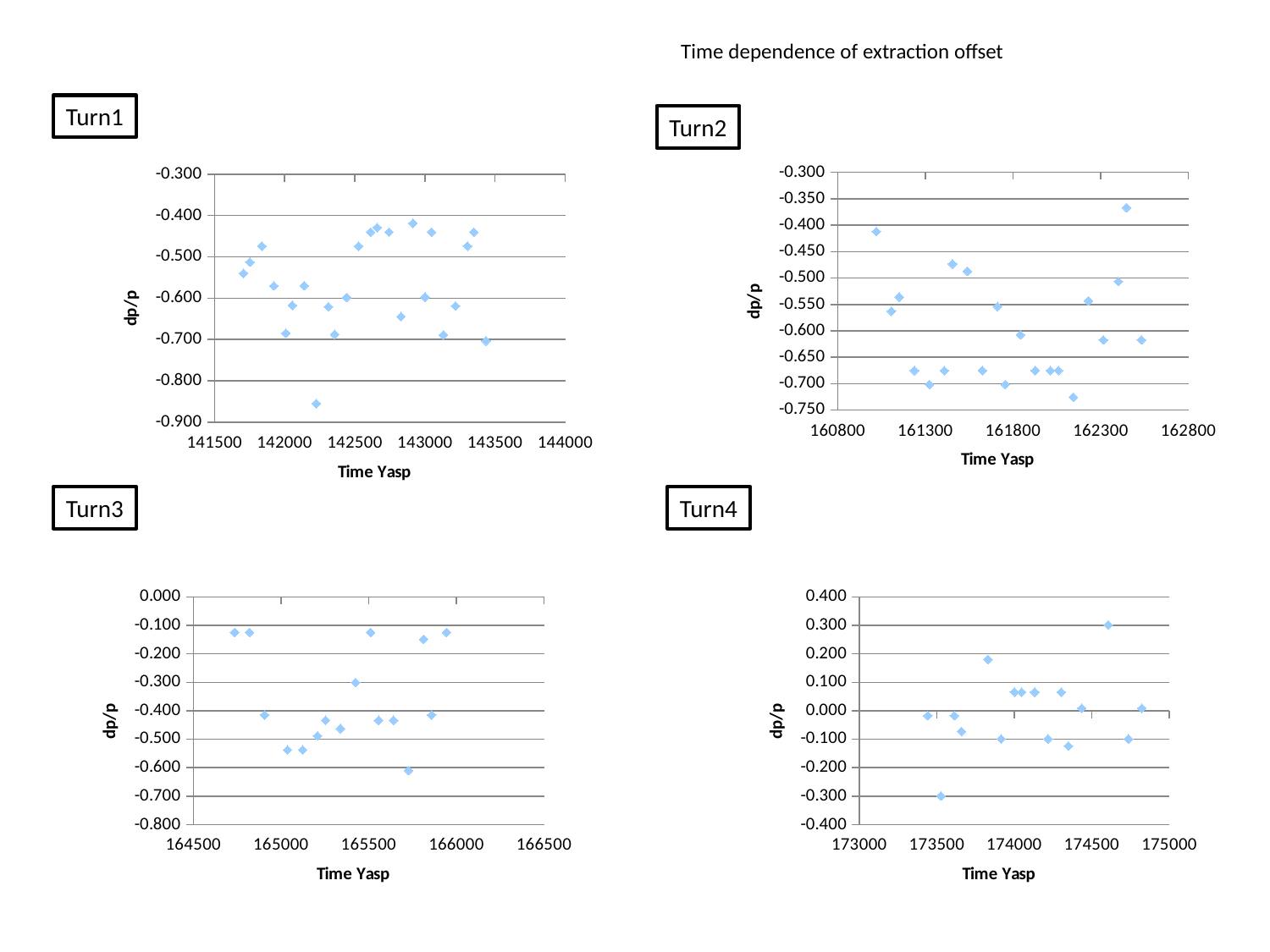
In the Turn1 chart, is the highest plotted dp/p value greater or less than -0.500? greater In the Turn1 chart, is the lowest plotted dp/p value greater or less than -0.800? less What kind of chart is the Turn1 chart? scatter chart In the Turn4 chart, is the lowest plotted dp/p value greater or less than -0.200? less What is the x-axis title of the Turn3 chart? Time Yasp What is the y-axis title of the Turn2 chart? dp/p How many charts are shown on the slide? 4